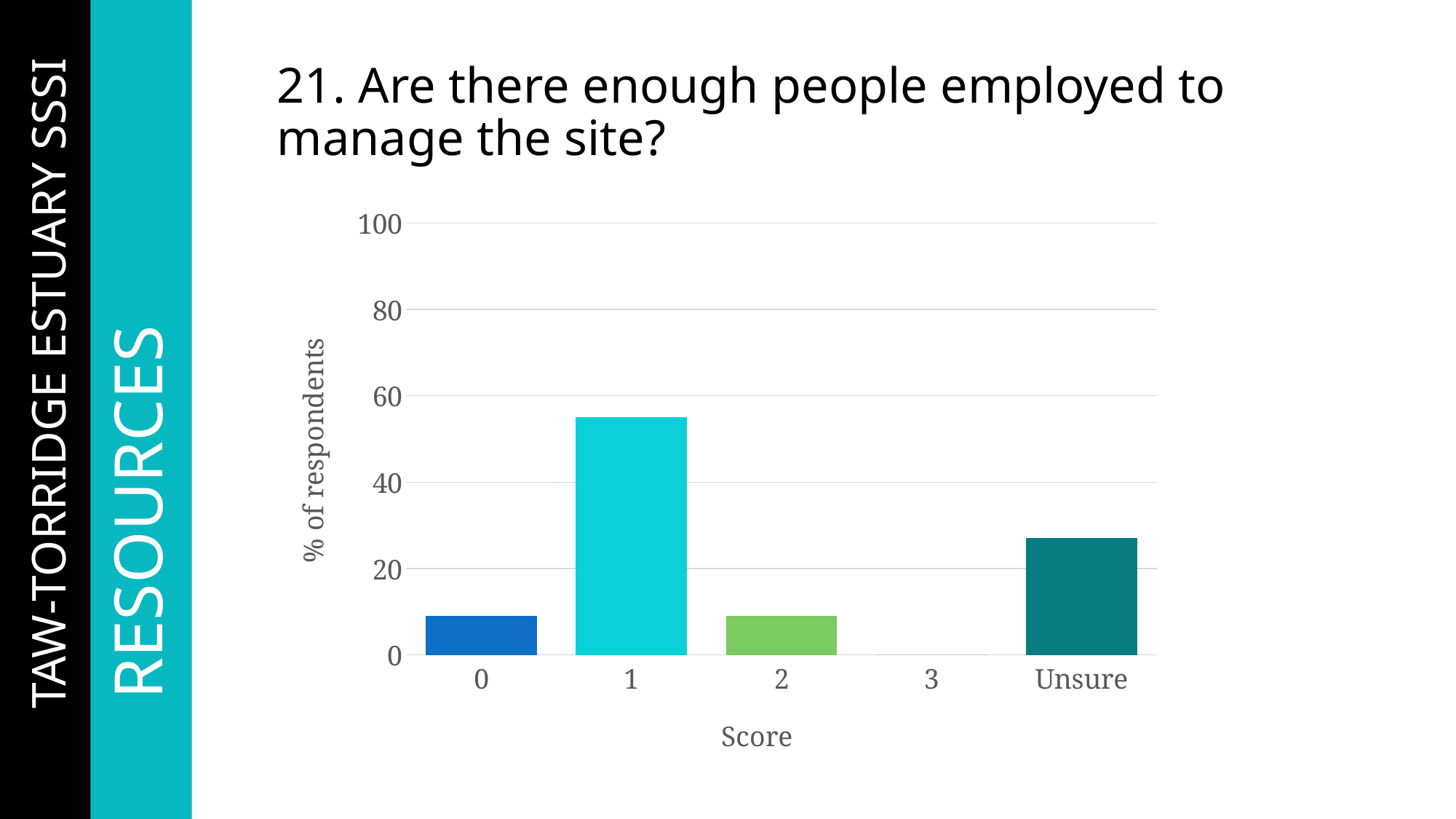
Is the value for score 1 greater or less than 40? greater Is the value for Unsure greater or less than 40? less How many score categories are shown on the x axis? 5 Which score category has the highest percentage of respondents? 1 What is the label on the y axis of the chart? % of respondents Is the value for score 1 greater or less than 60? less What kind of chart is shown on the slide? bar chart Which has a larger percentage of respondents, Unsure or score 2? Unsure Which has a larger percentage of respondents, score 1 or Unsure? 1 Which score category has the lowest percentage of respondents? 3